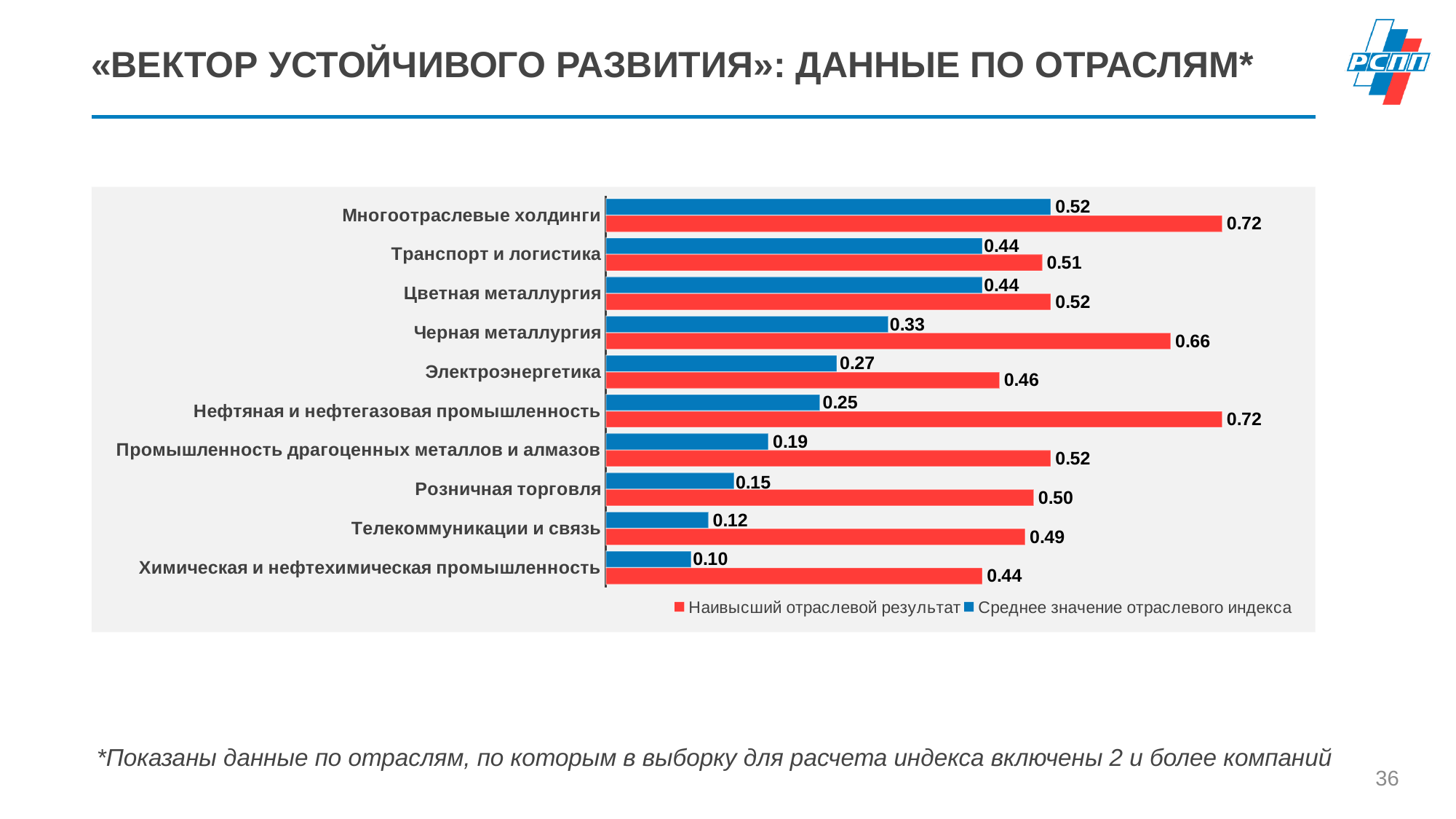
What type of chart is shown on the slide? Bar chart How many series does the legend list? 2 What is the highest industry result (Наивысший отраслевой результат) for Нефтяная и нефтегазовая промышленность? 0.72 Which industry has the highest average industry index value (blue bars)? Многоотраслевые холдинги What is the difference between the highest industry result and the average index value for Черная металлургия? 0.33 How many industries are shown in the chart? 10 What is the average industry index value (Среднее значение отраслевого индекса) for Черная металлургия? 0.33 Which colour represents the series Наивысший отраслевой результат? Red Which industry has the lowest average industry index value (blue bars)? Химическая и нефтехимическая промышленность Which industry has the lowest highest-industry-result value (red bars)? Химическая и нефтехимическая промышленность What is the average industry index value for Розничная торговля? 0.15 Which is larger: the highest industry result for Электроэнергетика or for Розничная торговля? Розничная торговля